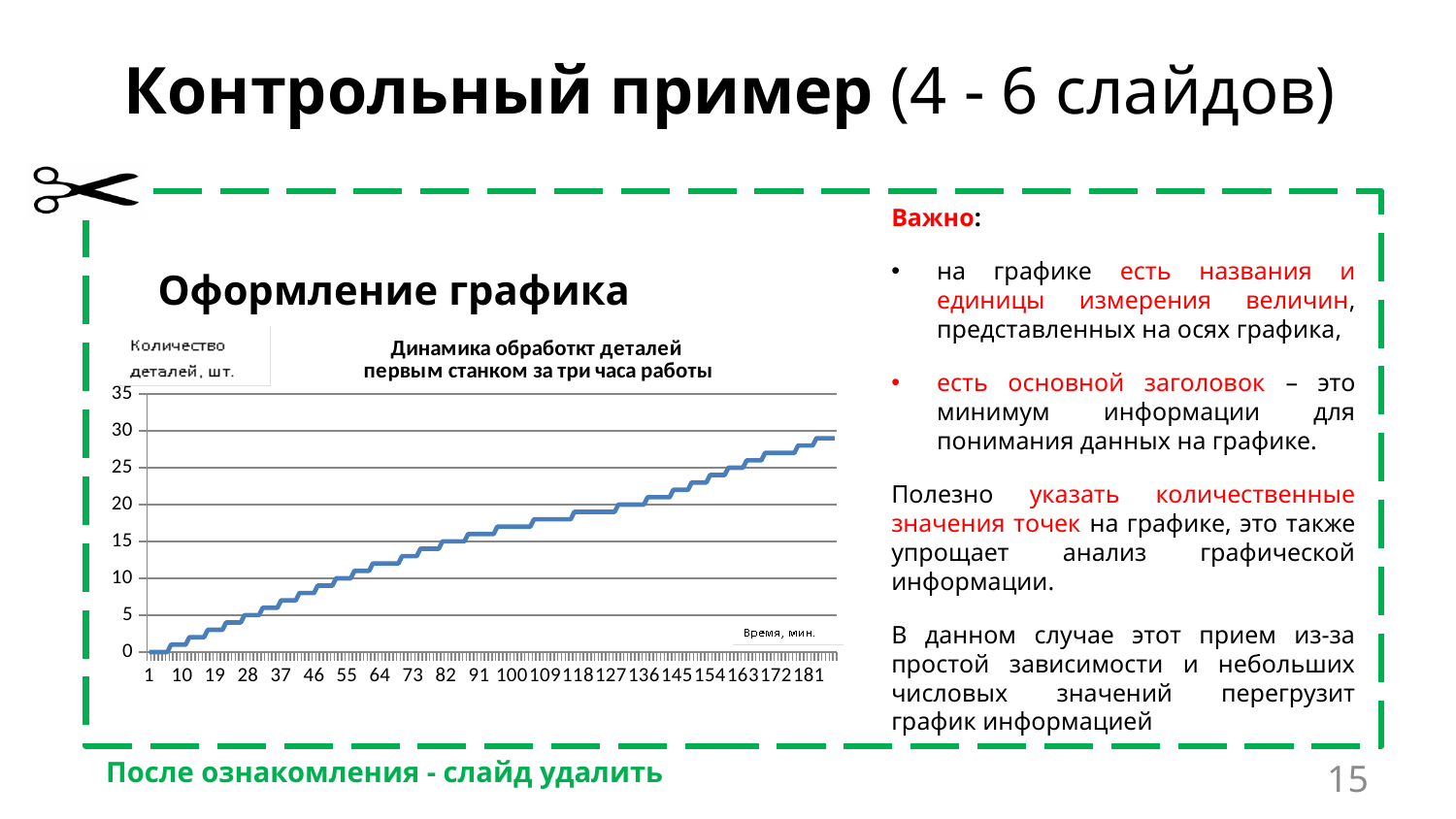
What is the title of the chart? Динамика обработкт деталей первым станком за три часа работы Do the values on the chart rise or fall as time increases along the x axis? rise Is the value at time 91 greater or less than 10? greater What kind of chart is shown on the slide? line chart What is the label of the vertical axis of the chart? Количество деталей, шт. Is the value at time 1 greater or less than 5? less Which is larger, the value at time 181 or the value at time 10? the value at time 181 What is the highest tick value shown on the vertical axis? 35 Is the value at time 181 greater or less than 25? greater How many tick labels are shown on the horizontal axis? 21